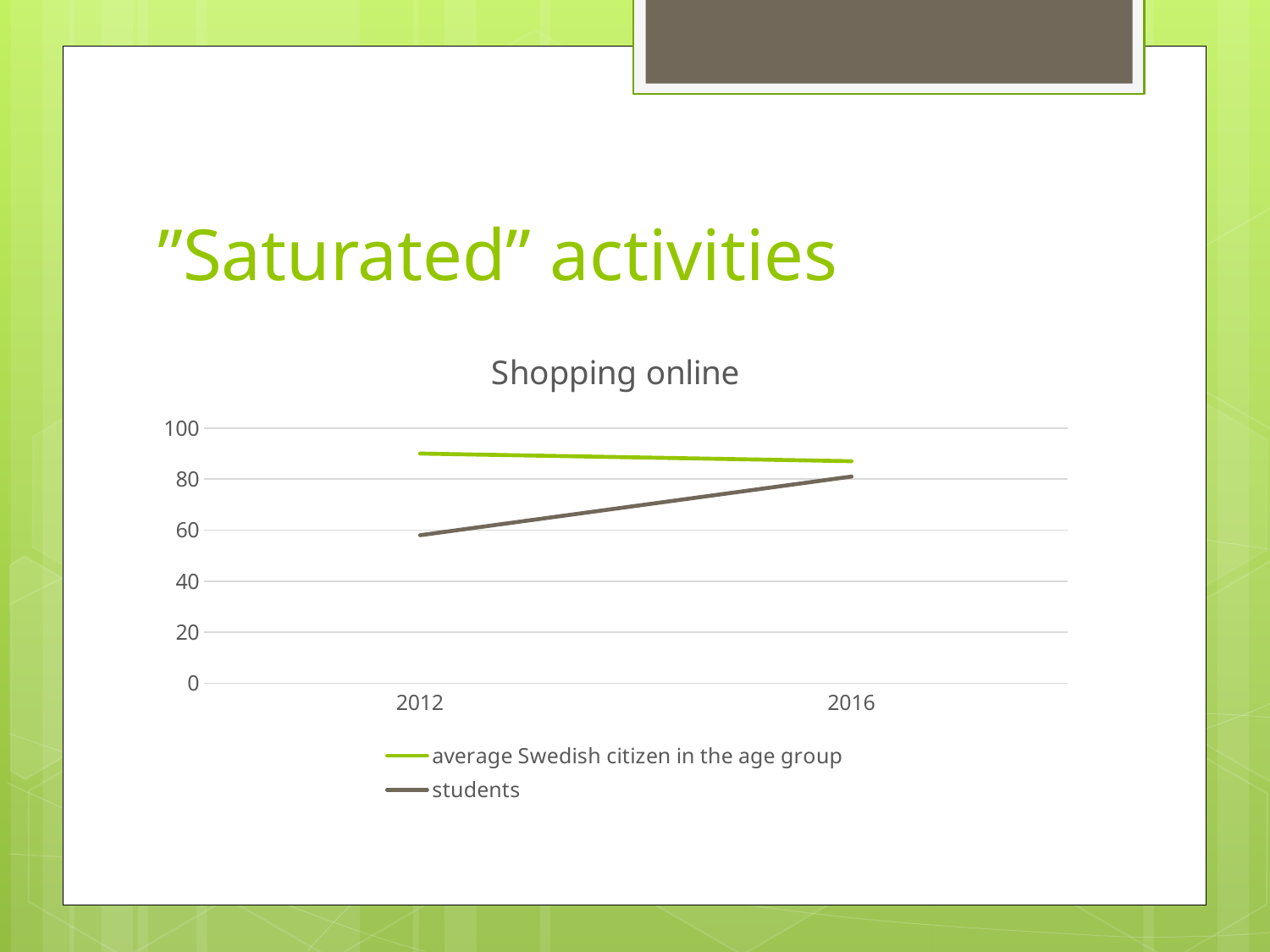
Is the value for the average Swedish citizen in the age group in 2016 greater or less than 100? less How many series does the legend list? 2 What is the title of the chart? Shopping online What kind of chart is shown on the slide? line chart Is the value for the average Swedish citizen in the age group in 2012 greater or less than 80? greater Does the value for students rise or fall from 2012 to 2016? rise Is the value for students in 2016 greater or less than 60? greater In 2012, which series has the higher value: average Swedish citizen in the age group or students? average Swedish citizen in the age group Does the value for the average Swedish citizen in the age group rise or fall from 2012 to 2016? fall How many years are shown on the x axis? 2 Which series is drawn in green? average Swedish citizen in the age group